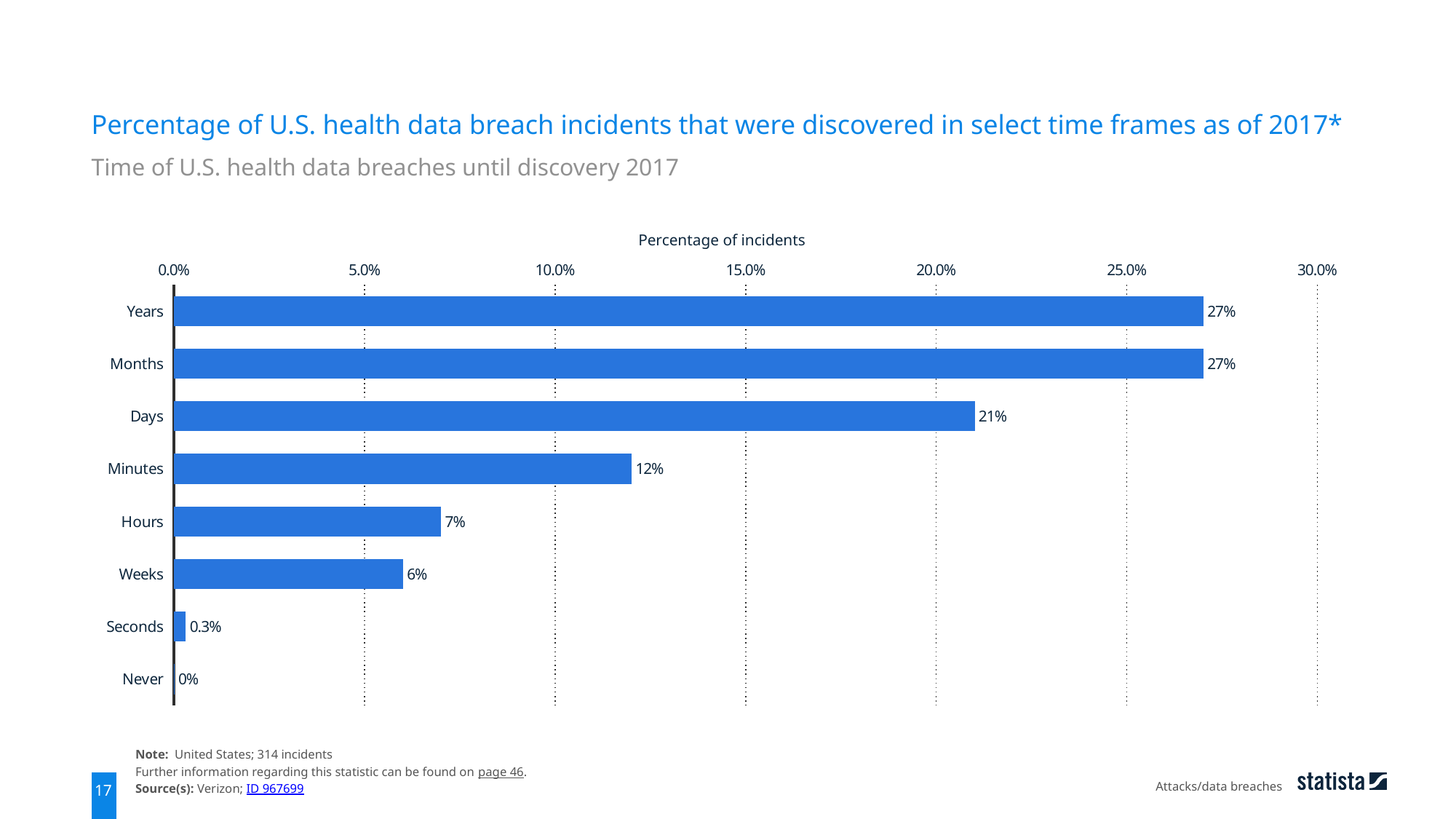
Is the value for Years greater or less than 25.0%? greater What type of chart is shown on the slide? Bar chart Which is larger, the value for Hours or the value for Weeks? Hours What percentage of incidents were discovered within days? 21% What is the difference in percentage points between Hours and Weeks? 1 What is the value shown for Never? 0% What is the label of the horizontal axis? Percentage of incidents How many time-frame categories are shown in the chart? 8 What is the value shown for Seconds? 0.3% What is the difference in percentage points between Days and Minutes? 9 Which category has the lowest percentage of incidents? Never What percentage of incidents were discovered within minutes? 12%